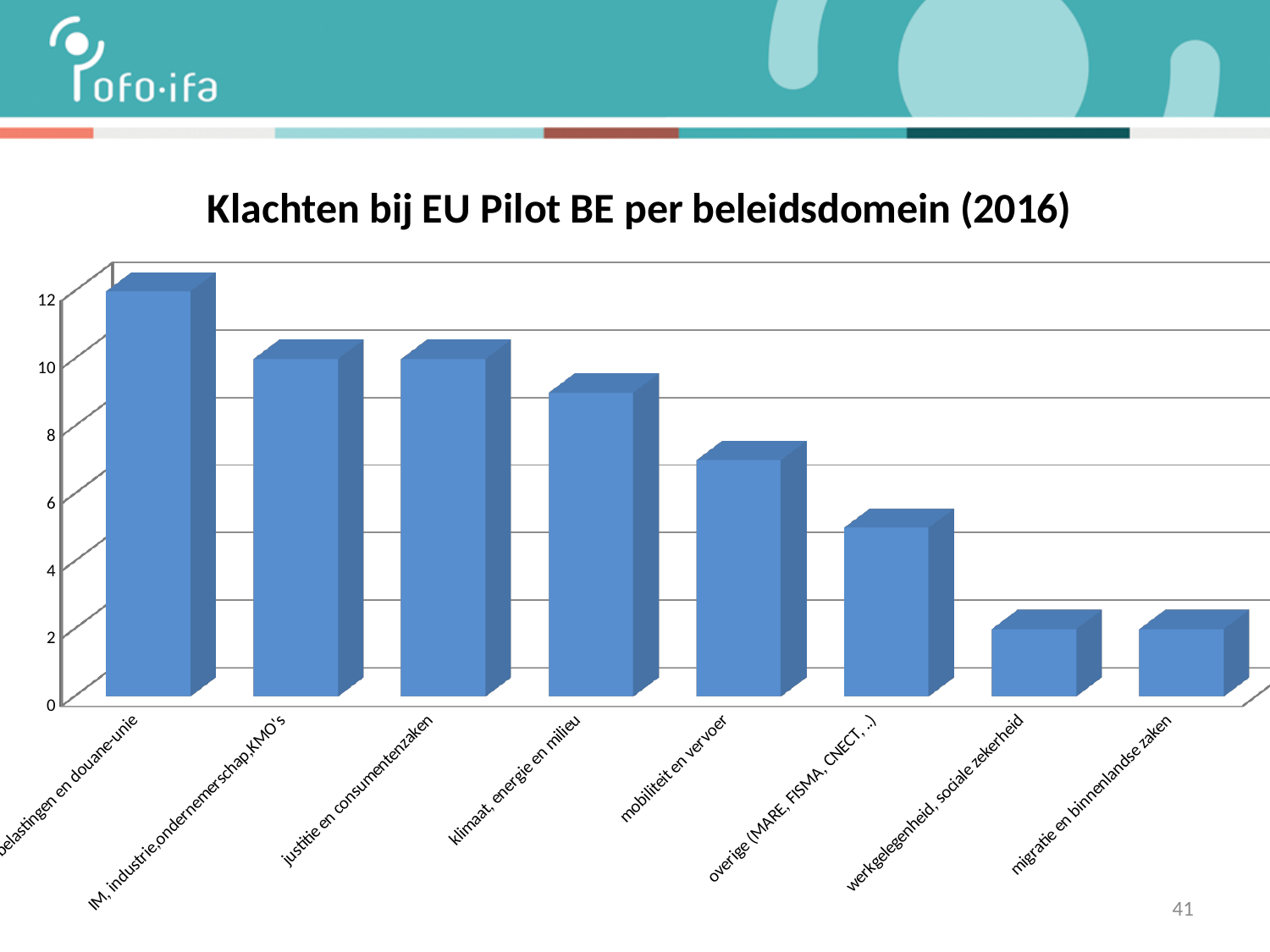
Is the value for klimaat, energie en milieu greater or less than 8? greater Is the value for werkgelegenheid, sociale zekerheid greater or less than 4? less Which is larger: the value for mobiliteit en vervoer or the value for overige (MARE, FISMA, CNECT, ..)? mobiliteit en vervoer Is the value for overige (MARE, FISMA, CNECT, ..) greater or less than 4? greater What is the value for migratie en binnenlandse zaken? 2 Do the values rise or fall from left to right along the x axis? fall What is the title of the chart? Klachten bij EU Pilot BE per beleidsdomein (2016) How many categories (beleidsdomeinen) are shown on the x axis? 8 What is the value for belastingen en douane-unie? 12 Which category has the highest number of complaints? belastingen en douane-unie What kind of chart is shown on the slide? bar chart